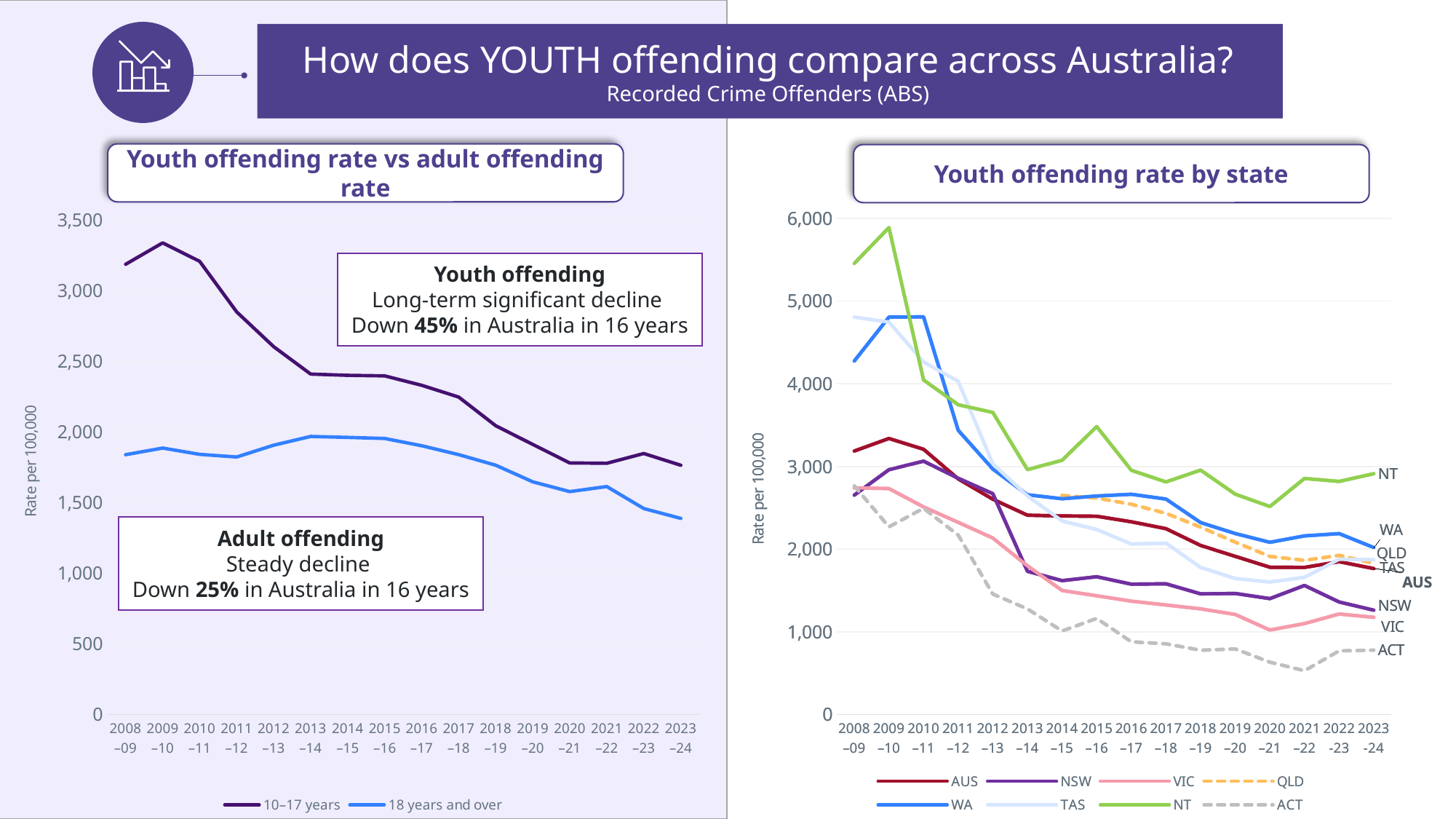
In the 'Youth offending rate vs adult offending rate' chart, does the 10–17 years series generally rise or fall from 2008–09 to 2023–24? fall In the 'Youth offending rate vs adult offending rate' chart, in which year does the 10–17 years series reach its highest value? 2009–10 In the 'Youth offending rate by state' chart, which series has the lowest value in 2023–24? ACT In the 'Youth offending rate vs adult offending rate' chart, which series is higher in 2009–10, 10–17 years or 18 years and over? 10–17 years In the 'Youth offending rate vs adult offending rate' chart, is the value for 10–17 years in 2008–09 greater or less than 3,000? greater How many series does the legend of the 'Youth offending rate vs adult offending rate' chart list? 2 In the 'Youth offending rate by state' chart, is the value for NT in 2009–10 greater or less than 5,000? greater In the 'Youth offending rate vs adult offending rate' chart, is the value for 18 years and over in 2023–24 greater or less than 1,500? less What kind of chart is the 'Youth offending rate vs adult offending rate' chart? line chart In the 'Youth offending rate vs adult offending rate' chart, how many years are plotted along the x axis? 16 In the 'Youth offending rate by state' chart, which state has the highest youth offending rate in 2023–24? NT How many series does the legend of the 'Youth offending rate by state' chart list? 8